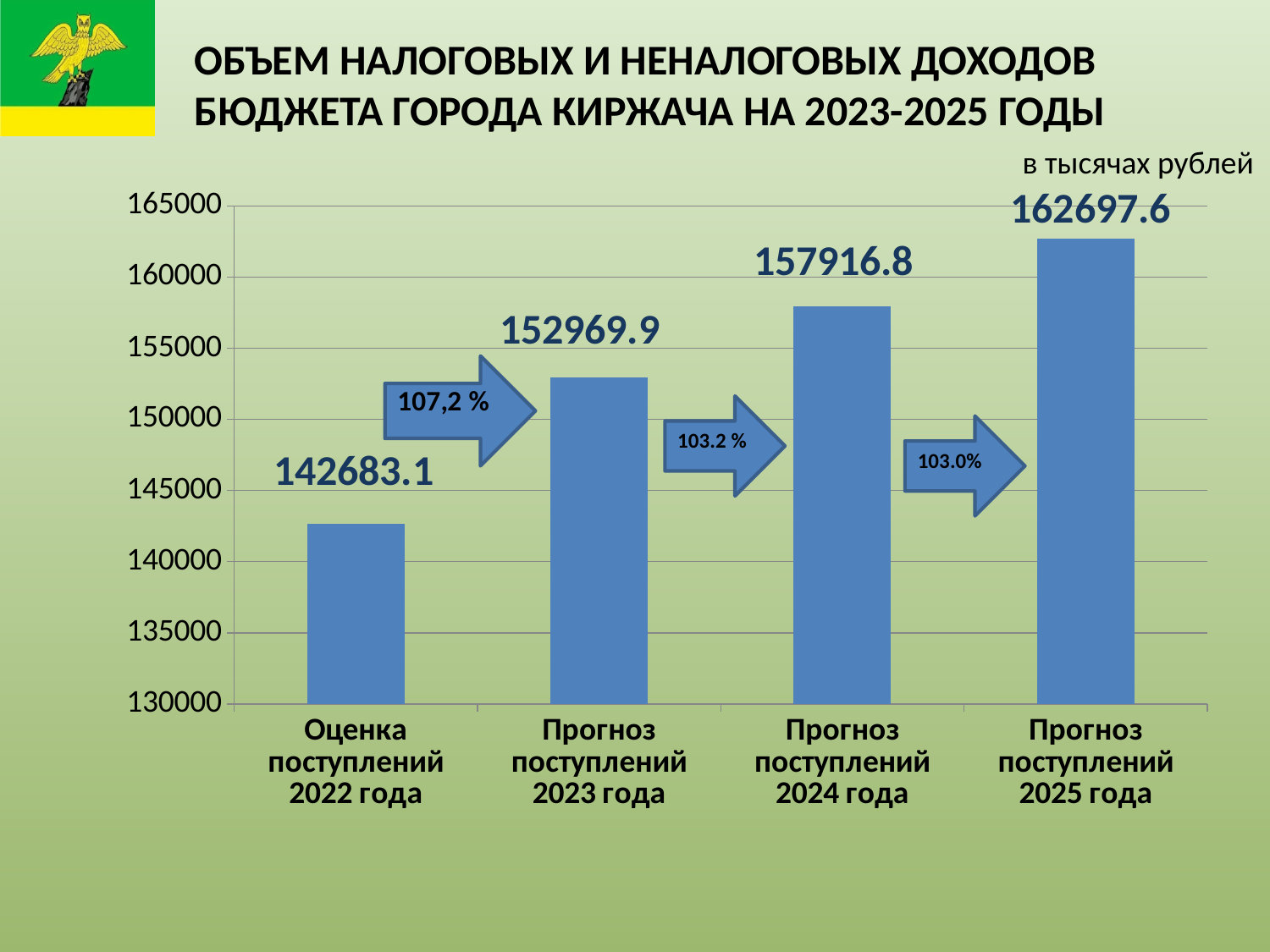
What is the value for "Прогноз поступлений 2024 года"? 157916.8 How many bars are shown in the chart? 4 What is the value for "Прогноз поступлений 2025 года"? 162697.6 Which category has the highest value? Прогноз поступлений 2025 года What kind of chart is shown on the slide? Bar chart Which category has the lowest value? Оценка поступлений 2022 года Do the values rise or fall from left to right along the x axis? Rise What is the difference between the values for "Прогноз поступлений 2023 года" and "Оценка поступлений 2022 года"? 10286.8 What is the value for "Прогноз поступлений 2023 года"? 152969.9 What is the value for "Оценка поступлений 2022 года"? 142683.1 What is the difference between the values for "Прогноз поступлений 2025 года" and "Прогноз поступлений 2024 года"? 4780.8 Which is larger: the value for "Прогноз поступлений 2024 года" or "Прогноз поступлений 2023 года"? Прогноз поступлений 2024 года